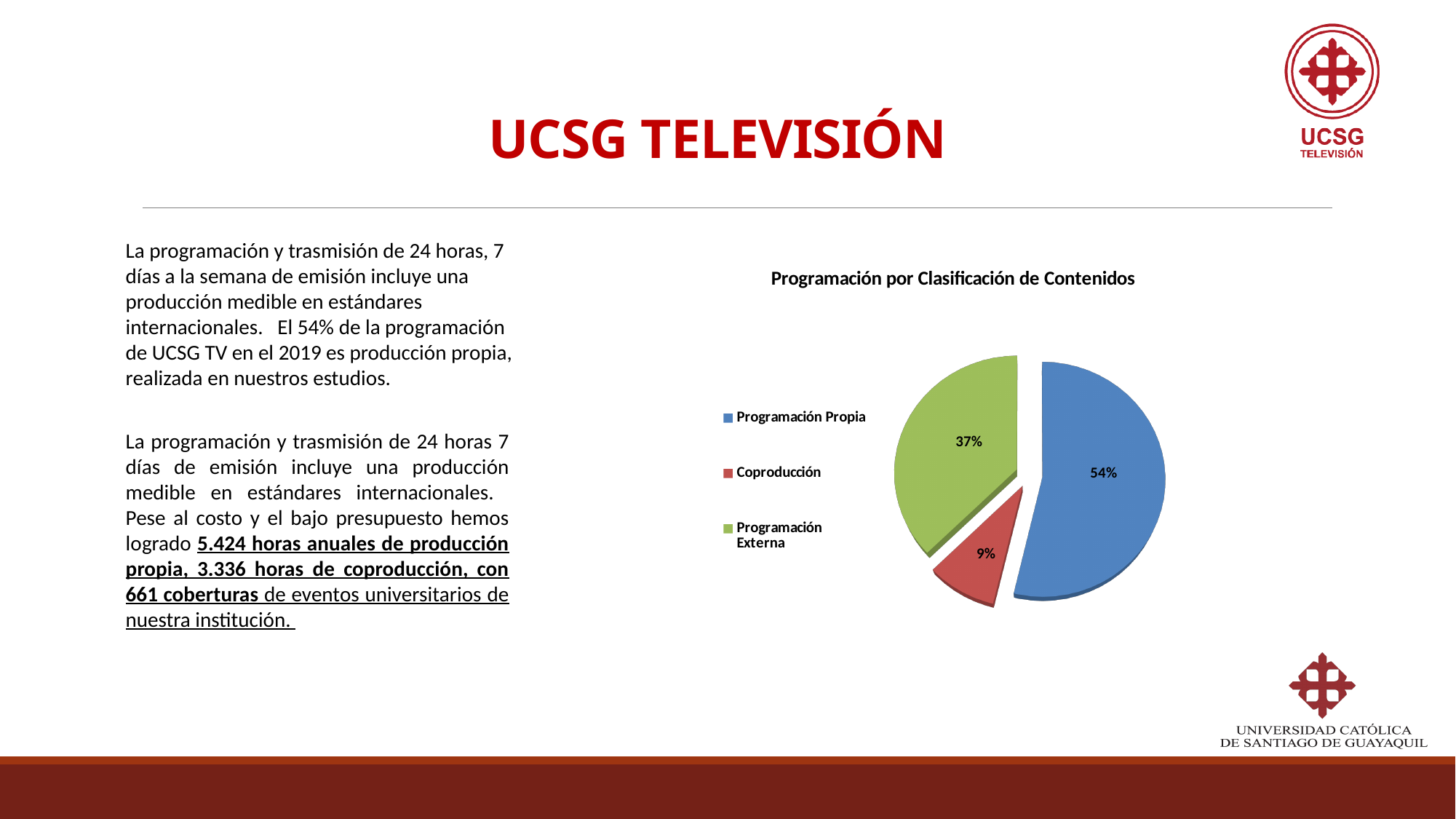
Which category has the smallest slice of the pie? Coproducción What is the combined share of Coproducción and Programación Externa? 46% What is the difference in percentage points between Programación Propia and Programación Externa? 17 How many categories does the pie chart show? 3 What share of the pie does Coproducción represent? 9% Which category has the largest slice of the pie? Programación Propia Which is larger, Programación Externa or Coproducción? Programación Externa What is the title of the chart? Programación por Clasificación de Contenidos What colour is the Coproducción slice? Red What type of chart is shown on the slide? Pie chart What share of the pie does Programación Propia represent? 54% What share of the pie does Programación Externa represent? 37%